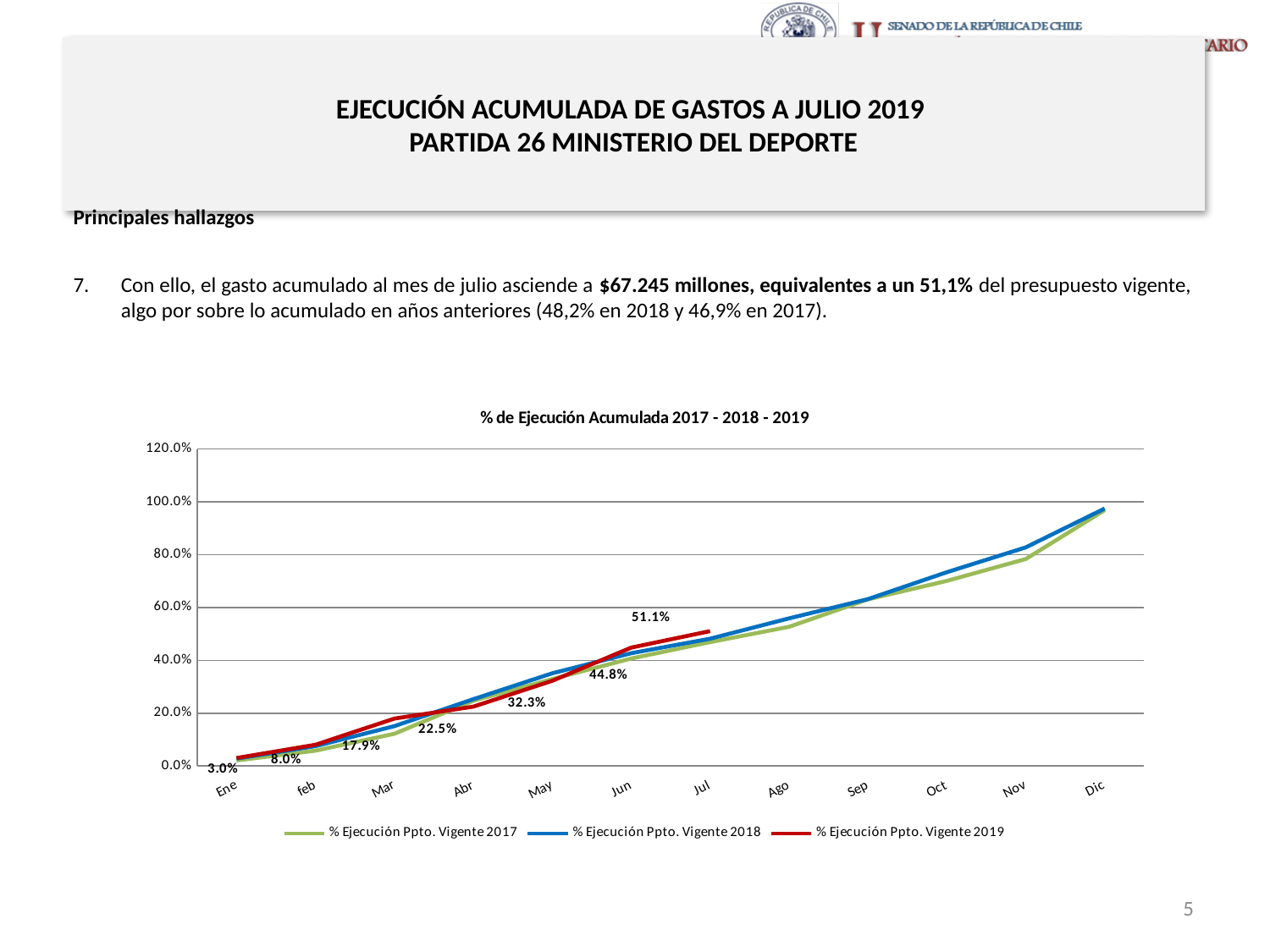
What is the value for % Ejecución Ppto. Vigente 2019 in Ene? 3.0% How many series does the legend list? 3 What is the difference between the 2019 values for Jul and Jun? 6.3% Is the value for % Ejecución Ppto. Vigente 2018 in Dic greater or less than 80.0%? greater What is the value for % Ejecución Ppto. Vigente 2019 in Mar? 17.9% Does the % Ejecución Ppto. Vigente 2019 line rise or fall from Ene to Jul? rise Is the value for % Ejecución Ppto. Vigente 2017 in Sep greater or less than 80.0%? less What kind of chart is shown on the slide? line chart What is the value for % Ejecución Ppto. Vigente 2019 in Jul? 51.1% What is the title of the chart? % de Ejecución Acumulada 2017 - 2018 - 2019 What is the value for % Ejecución Ppto. Vigente 2019 in Jun? 44.8% How many months are shown on the x axis? 12